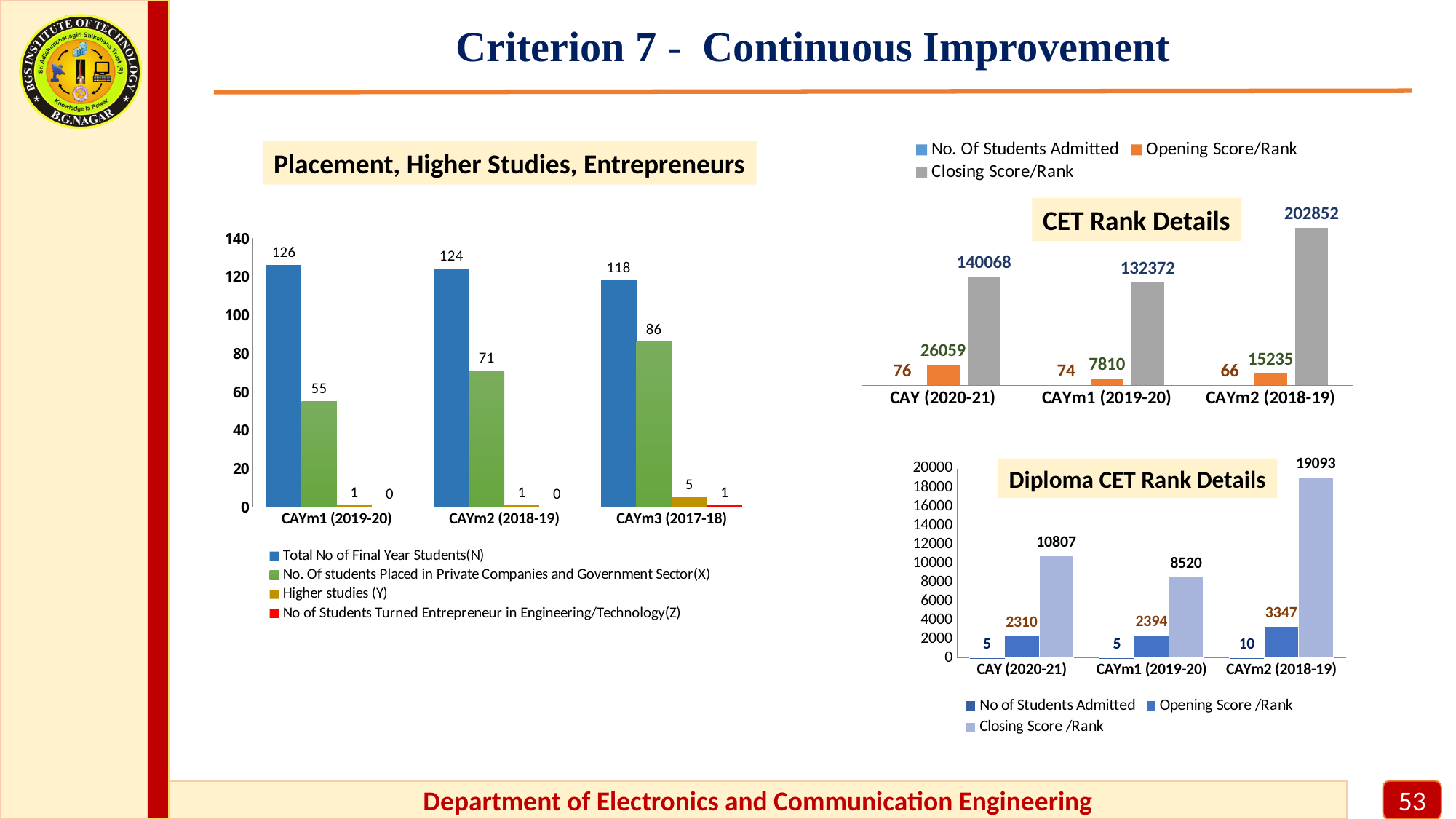
In the 'CET Rank Details' chart, which year has the lowest Opening Score/Rank? CAYm1 (2019-20) In the 'CET Rank Details' chart, how many students were admitted in CAY (2020-21)? 76 In the 'Diploma CET Rank Details' chart, what is the difference between the Closing Score/Rank and the Opening Score/Rank for CAYm2 (2018-19)? 15746 In the 'Placement, Higher Studies, Entrepreneurs' chart, how many students turned entrepreneur in CAYm3 (2017-18)? 1 What kind of chart is the 'Diploma CET Rank Details' chart? Bar chart In the 'Placement, Higher Studies, Entrepreneurs' chart, which year has the highest number of students placed in private companies and government sector (X)? CAYm3 (2017-18) In the 'CET Rank Details' chart, is the Closing Score/Rank larger for CAY (2020-21) or CAYm1 (2019-20)? CAY (2020-21) In the 'CET Rank Details' chart, what is the Closing Score/Rank for CAYm2 (2018-19)? 202852 In the 'Placement, Higher Studies, Entrepreneurs' chart, how many series does the legend list? 4 In the 'Placement, Higher Studies, Entrepreneurs' chart, what is the difference between the total number of final year students and the number placed for CAYm1 (2019-20)? 71 In the 'Placement, Higher Studies, Entrepreneurs' chart, what is the Total No of Final Year Students(N) for CAYm2 (2018-19)? 124 In the 'Diploma CET Rank Details' chart, what is the Opening Score/Rank for CAYm1 (2019-20)? 2394